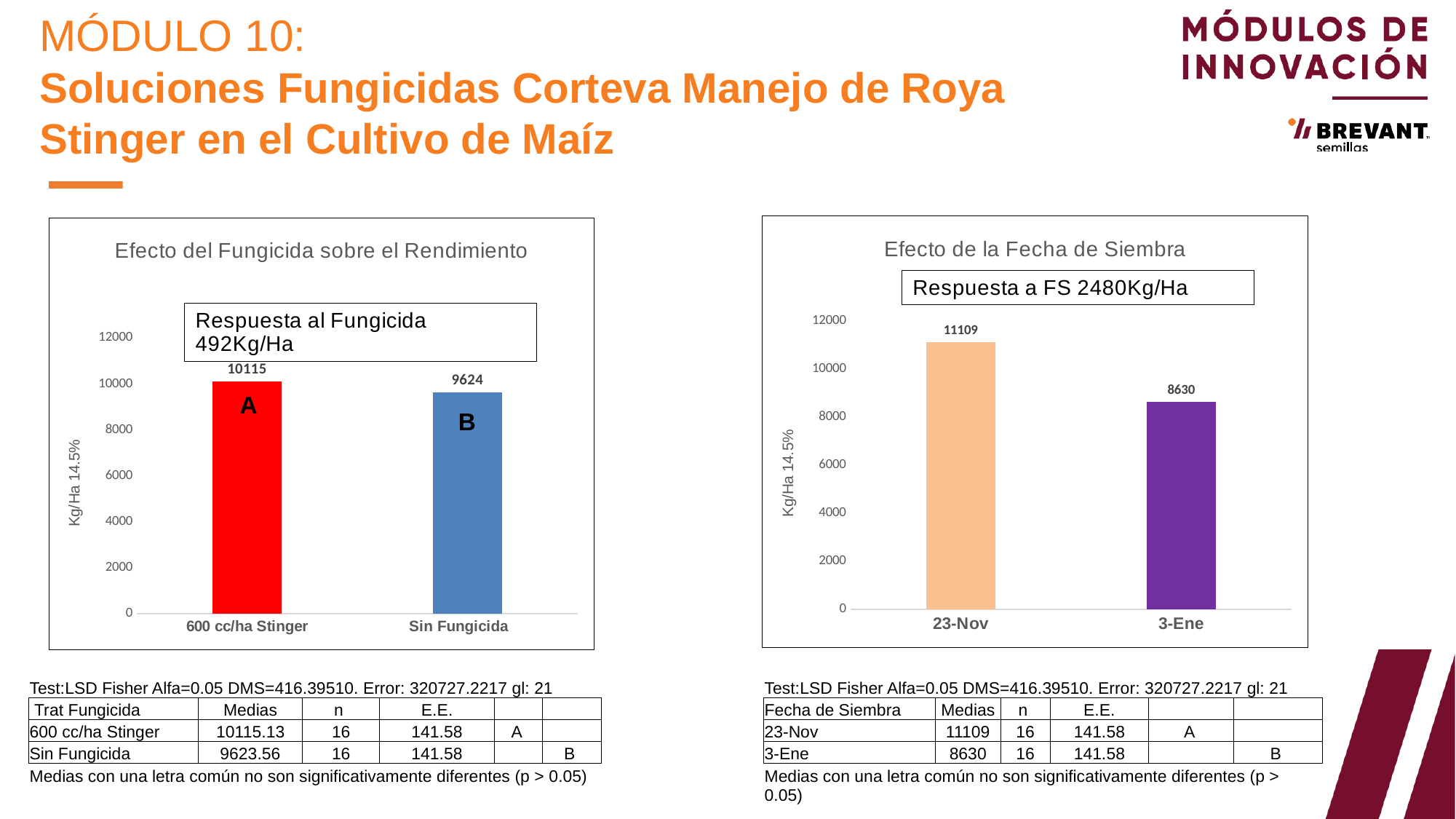
In the chart 'Efecto del Fungicida sobre el Rendimiento', what is the value for Sin Fungicida? 9624 In the chart 'Efecto de la Fecha de Siembra', what is the difference between the values for 23-Nov and 3-Ene? 2479 In the chart 'Efecto de la Fecha de Siembra', what is the value for 23-Nov? 11109 In the chart 'Efecto de la Fecha de Siembra', what is the value for 3-Ene? 8630 In the chart 'Efecto del Fungicida sobre el Rendimiento', which category has the highest value? 600 cc/ha Stinger In the chart 'Efecto de la Fecha de Siembra', which category has the lowest value? 3-Ene What is the y-axis label of the chart 'Efecto de la Fecha de Siembra'? Kg/Ha 14.5% In the chart 'Efecto de la Fecha de Siembra', is the value for 3-Ene greater or less than 10000? less In the chart 'Efecto del Fungicida sobre el Rendimiento', how many categories are plotted? 2 What kind of chart is 'Efecto del Fungicida sobre el Rendimiento'? Bar chart In the chart 'Efecto del Fungicida sobre el Rendimiento', what is the value for 600 cc/ha Stinger? 10115 In the chart 'Efecto del Fungicida sobre el Rendimiento', what is the difference between the values for 600 cc/ha Stinger and Sin Fungicida? 491